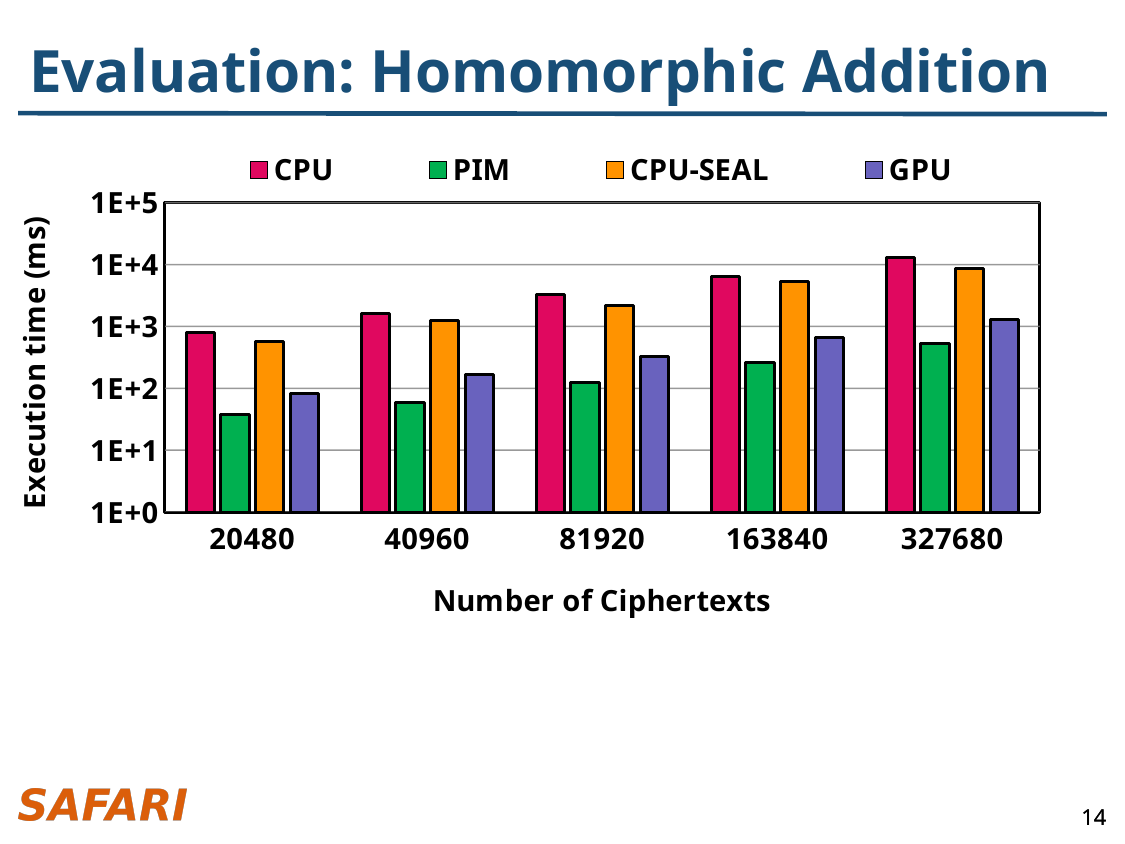
Which series has the lowest execution time at 327680 ciphertexts? PIM Is the PIM execution time at 327680 ciphertexts greater or less than 1E+3 ms? less Is the CPU execution time at 327680 ciphertexts greater or less than 1E+4 ms? greater What kind of chart is shown on the slide? bar chart Which series has the highest execution time at 327680 ciphertexts? CPU How many series does the legend list? 4 How many categories (numbers of ciphertexts) are shown on the x axis? 5 Does the CPU execution time rise or fall as the number of ciphertexts increases? rise Is the CPU-SEAL execution time at 163840 ciphertexts greater or less than 1E+3 ms? greater At 20480 ciphertexts, which has the larger execution time, CPU or CPU-SEAL? CPU What is the label of the y axis? Execution time (ms)